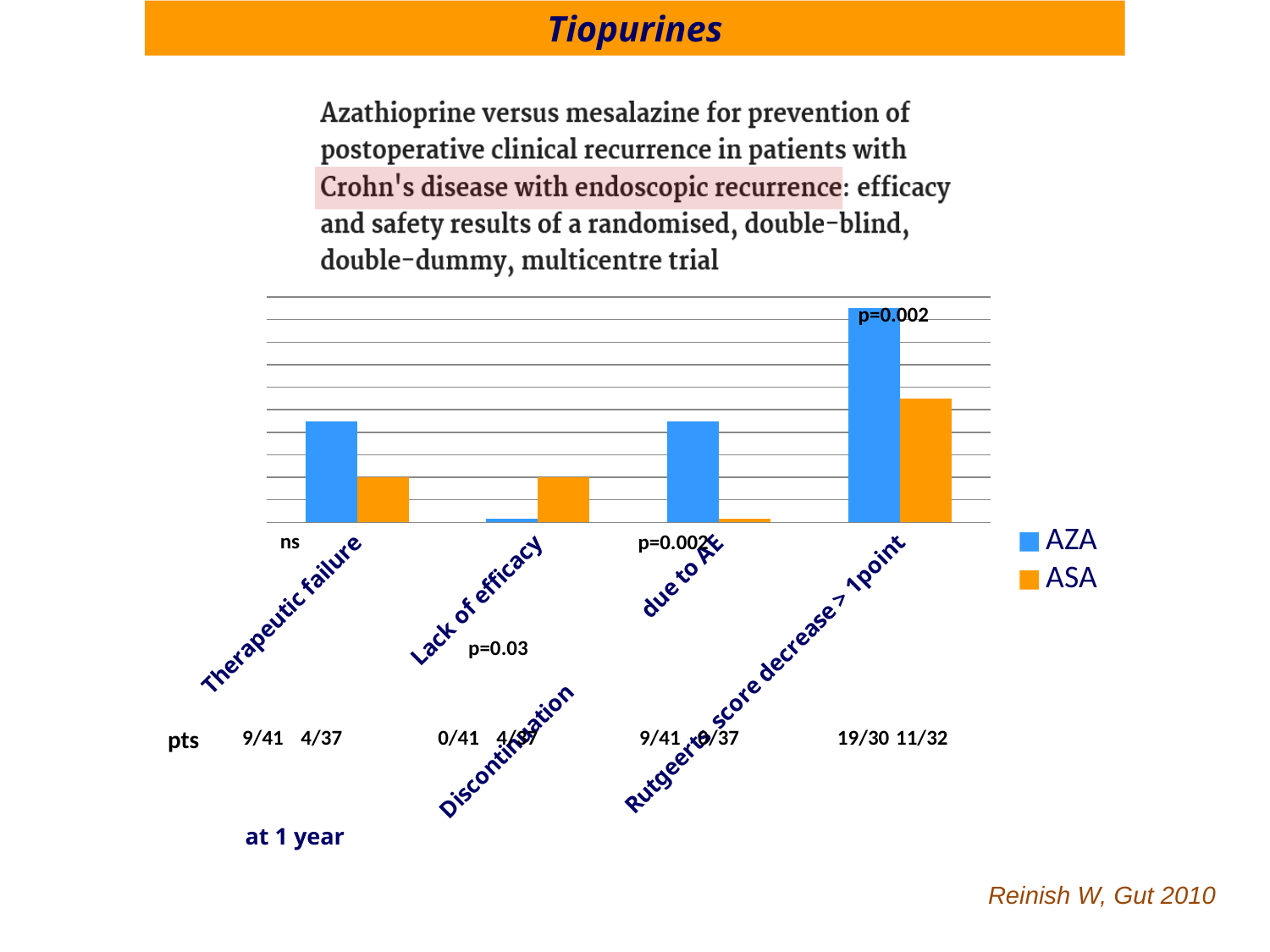
How many series does the legend list? 2 In which category is the AZA bar the tallest? Rutgeerts score decrease > 1point What kind of chart is shown on the slide? bar chart What is the pts value for AZA in the Rutgeerts score decrease > 1point category? 19/30 What is the pts value for ASA in the Therapeutic failure category? 4/37 What p-value is printed above the Rutgeerts score decrease > 1point bars? p=0.002 What is the pts value for ASA in the Rutgeerts score decrease > 1point category? 11/32 What is the pts value for AZA in the Therapeutic failure category? 9/41 What are the two series named in the legend? AZA and ASA How many categories are plotted along the x axis? 4 In the Rutgeerts score decrease > 1point category, which series has the taller bar, AZA or ASA? AZA What is the pts value for AZA in the Lack of efficacy category? 0/41